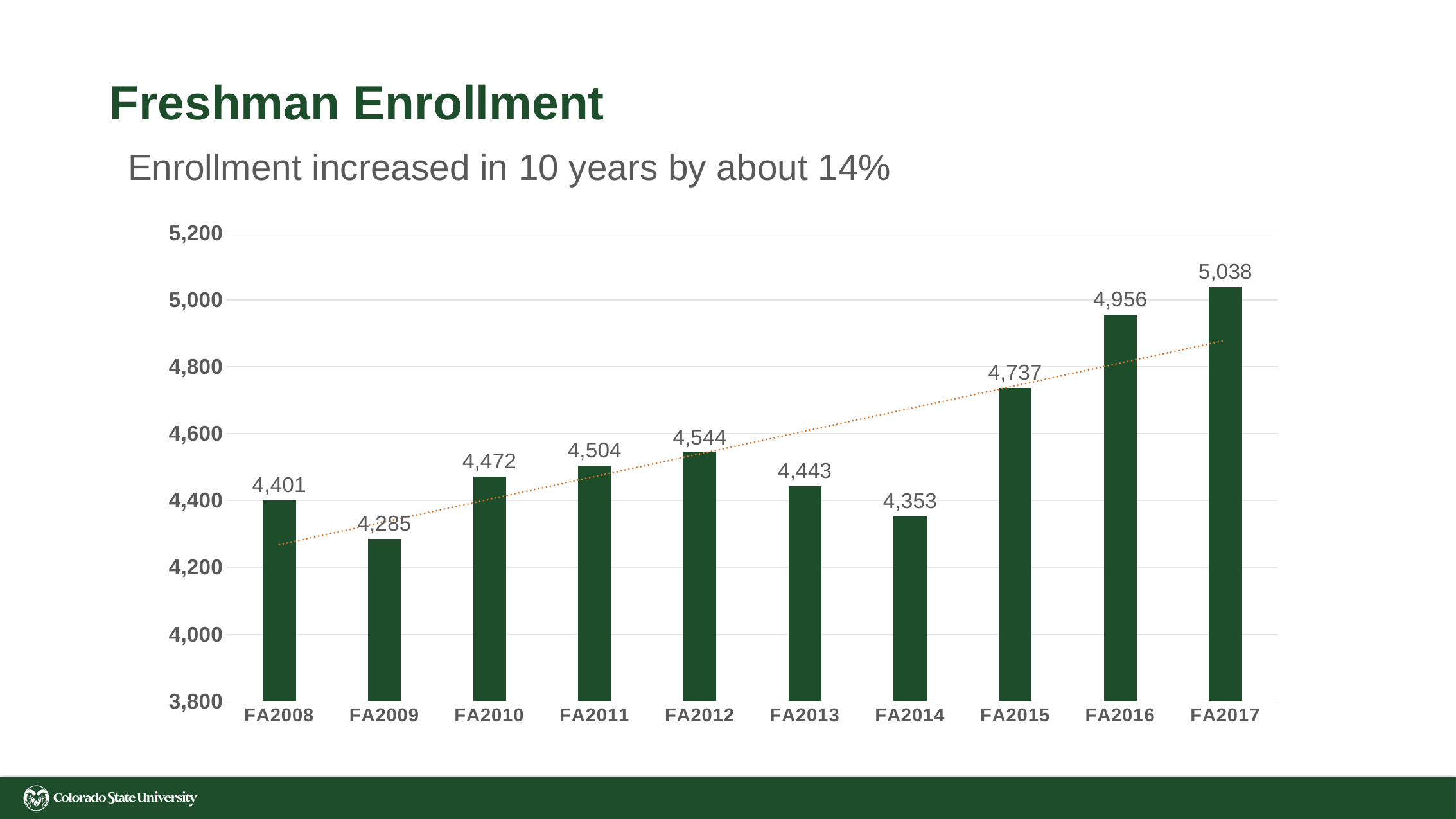
What is the freshman enrollment value for FA2015? 4,737 What is the difference in enrollment between FA2017 and FA2008? 637 How many years are shown on the x axis of the chart? 10 What is the freshman enrollment value for FA2012? 4,544 Is the enrollment value for FA2016 greater or less than 4,800? greater Which year has the highest freshman enrollment? FA2017 Which year has the lowest freshman enrollment? FA2009 Which year has higher enrollment, FA2013 or FA2014? FA2013 What is the difference in enrollment between FA2016 and FA2015? 219 What is the freshman enrollment value for FA2009? 4,285 What is the title of the slide containing the chart? Freshman Enrollment What kind of chart is shown on the slide? bar chart